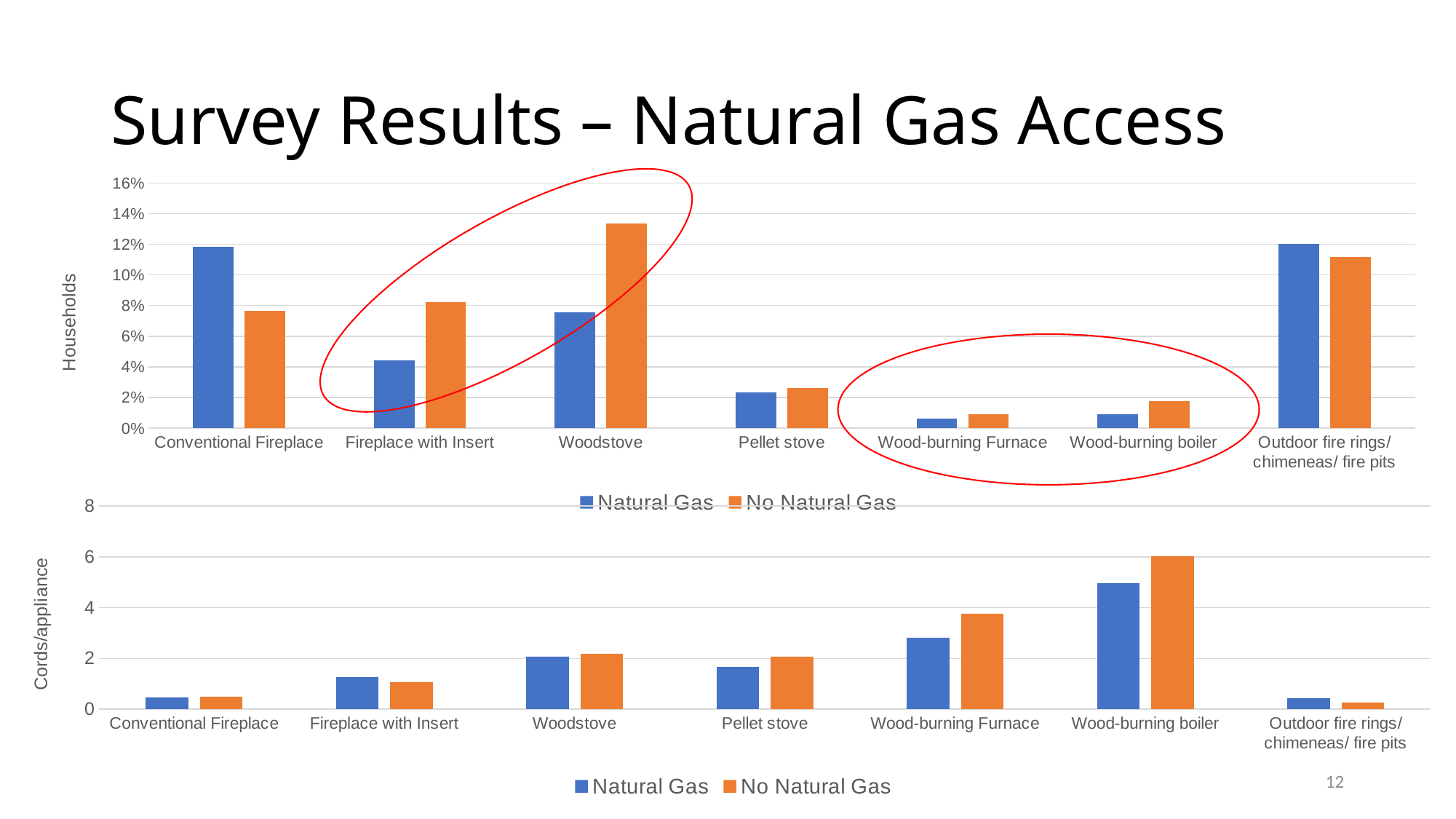
On the top chart (Households), which category has the highest No Natural Gas value? Woodstove On the bottom chart (Cords/appliance), is the Natural Gas value for Wood-burning boiler greater or less than 4? greater On the bottom chart (Cords/appliance), which category has the lowest No Natural Gas value? Outdoor fire rings/ chimeneas/ fire pits On the top chart (Households), for Fireplace with Insert, which series has the larger value: Natural Gas or No Natural Gas? No Natural Gas On the bottom chart (Cords/appliance), for Outdoor fire rings/ chimeneas/ fire pits, which series has the larger value: Natural Gas or No Natural Gas? Natural Gas On the top chart (Households), which category has the lowest No Natural Gas value? Wood-burning Furnace On the bottom chart (Cords/appliance), which category has the highest No Natural Gas value? Wood-burning boiler How many appliance categories are shown on the bottom chart (Cords/appliance)? 7 How many series does the legend of the top chart (Households) list? 2 What is the y-axis label of the bottom chart? Cords/appliance What kind of chart is the top chart (Households)? Bar chart On the top chart (Households), is the No Natural Gas value for Woodstove greater or less than 12%? greater